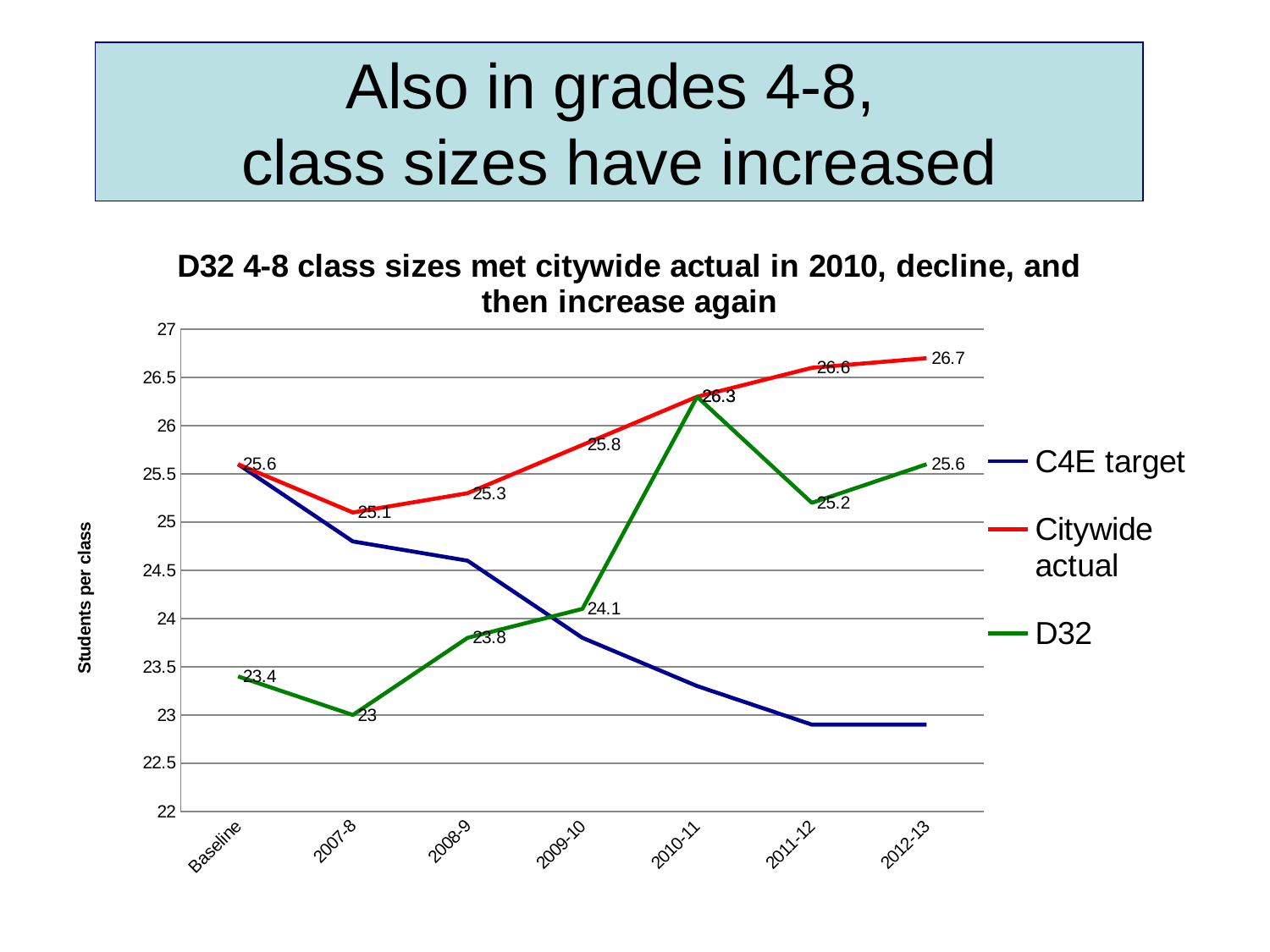
In 2011-12, which is larger: the D32 value or the Citywide actual value? Citywide actual What is the D32 value for 2007-8? 23 Is the C4E target value for 2011-12 greater or less than 23.5? less In which year is the D32 value lowest? 2007-8 What is the Citywide actual value for 2012-13? 26.7 How many series does the legend list? 3 How many points are shown along the x axis? 7 Does the C4E target series rise or fall from Baseline to 2012-13? fall What kind of chart is shown on the slide? line chart In which year does the D32 series reach its highest value? 2010-11 How much higher is the Citywide actual value in 2012-13 than at Baseline? 1.1 What is the D32 value at Baseline? 23.4